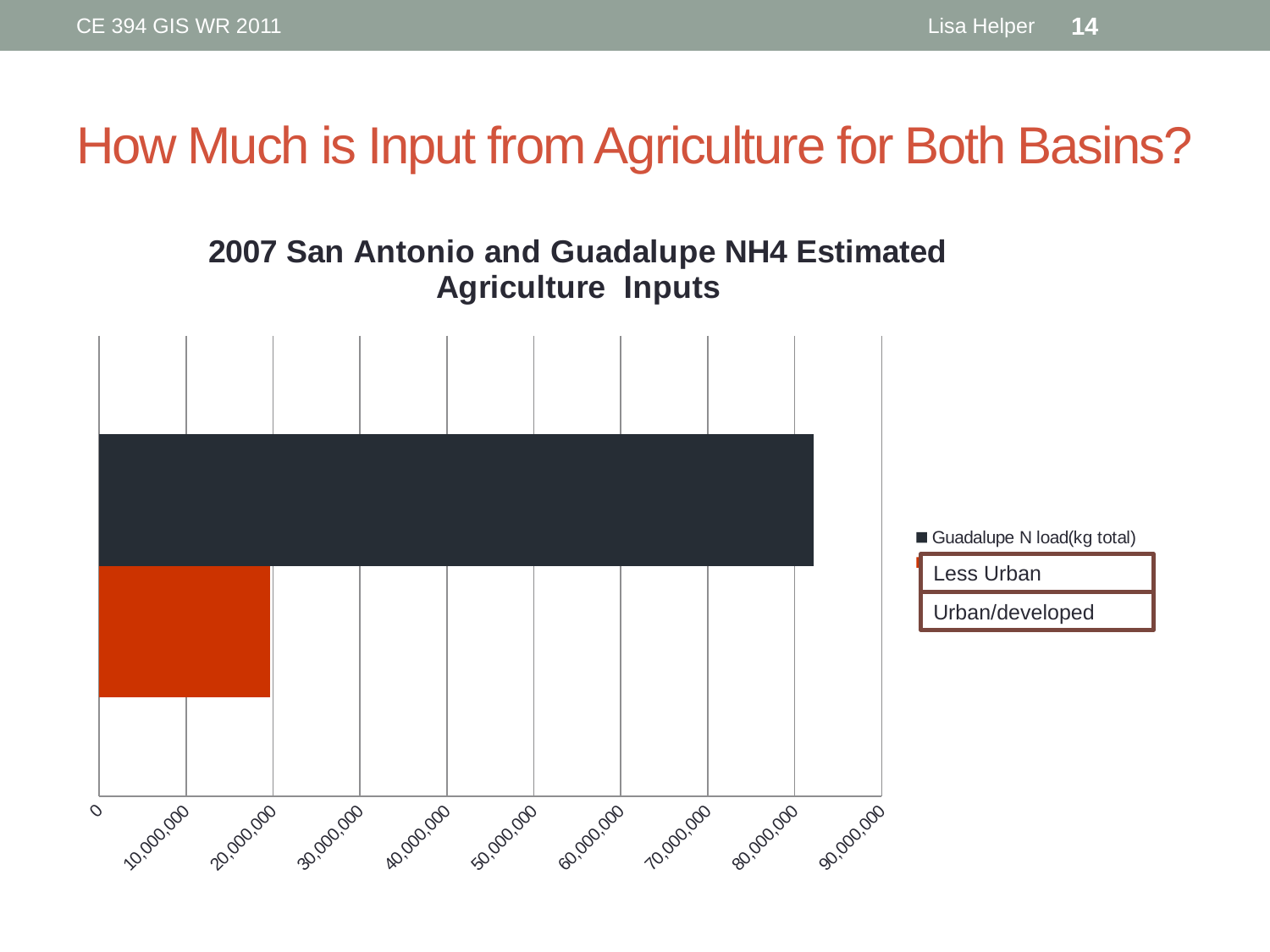
Which series name is readable in the chart legend? Guadalupe N load(kg total) Is the value for Guadalupe N load(kg total) greater or less than 50,000,000? greater Is the value of the orange bar greater or less than 30,000,000? less Is the value for Guadalupe N load(kg total) greater or less than 80,000,000? greater What kind of chart is shown on the slide? Bar chart Which series has the highest value in the chart? Guadalupe N load(kg total) Which bar is longer, the dark bar or the orange bar? The dark bar How many bars are plotted in the chart? 2 What is the title of the chart? 2007 San Antonio and Guadalupe NH4 Estimated Agriculture Inputs